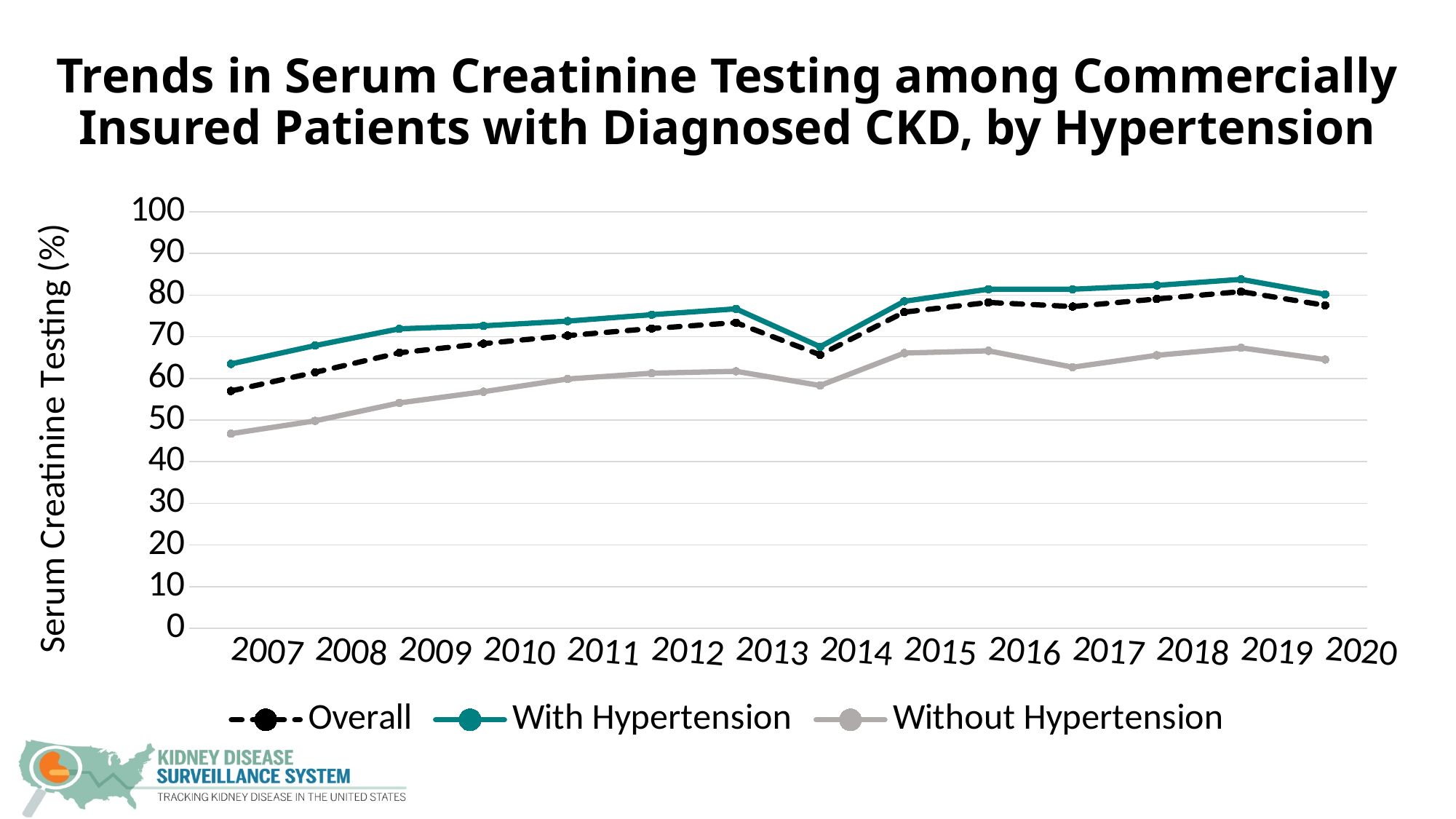
Is the value for Overall in 2007 greater or less than 60? less Is the value for With Hypertension in 2019 greater or less than 80? greater Does the Overall series rise or fall from 2007 to 2013? Rise Which series has the lowest values across all years shown? Without Hypertension Is the value for Without Hypertension in 2007 greater or less than 50? less In which year does the Without Hypertension series have its lowest value? 2007 What kind of chart is shown on the slide? Line chart In 2014, which is larger: the value for With Hypertension or Without Hypertension? With Hypertension Which series is drawn with a dashed line? Overall How many years are shown on the x axis? 14 How many series does the legend list? 3 In which year does the With Hypertension series reach its highest value? 2019